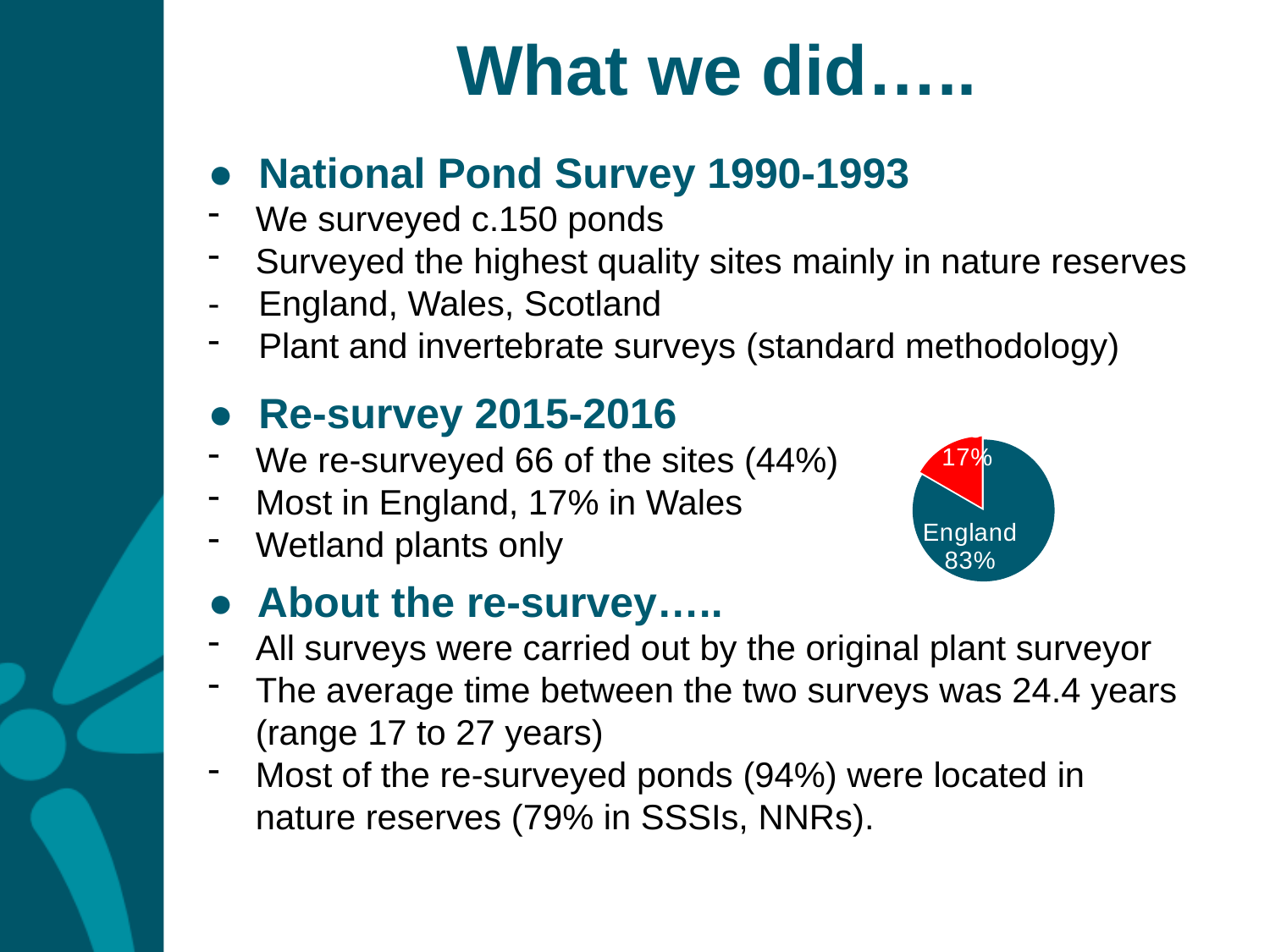
What do the two slices of the pie chart add up to? 100% Is the England slice of the pie chart greater or less than 50%? greater What kind of chart is shown on the slide? pie chart What colour is the England slice of the pie chart? dark teal What share of the pie chart is labelled England? 83% What is the difference in percentage points between the England slice and the 17% slice? 66 Which slice of the pie chart is the largest? England What percentage is shown on the red slice of the pie chart? 17% How many slices does the pie chart have? 2 What colour is the 17% slice of the pie chart? red Which is larger in the pie chart, the England slice or the red slice? England Which slice of the pie chart is the smallest? the red 17% slice